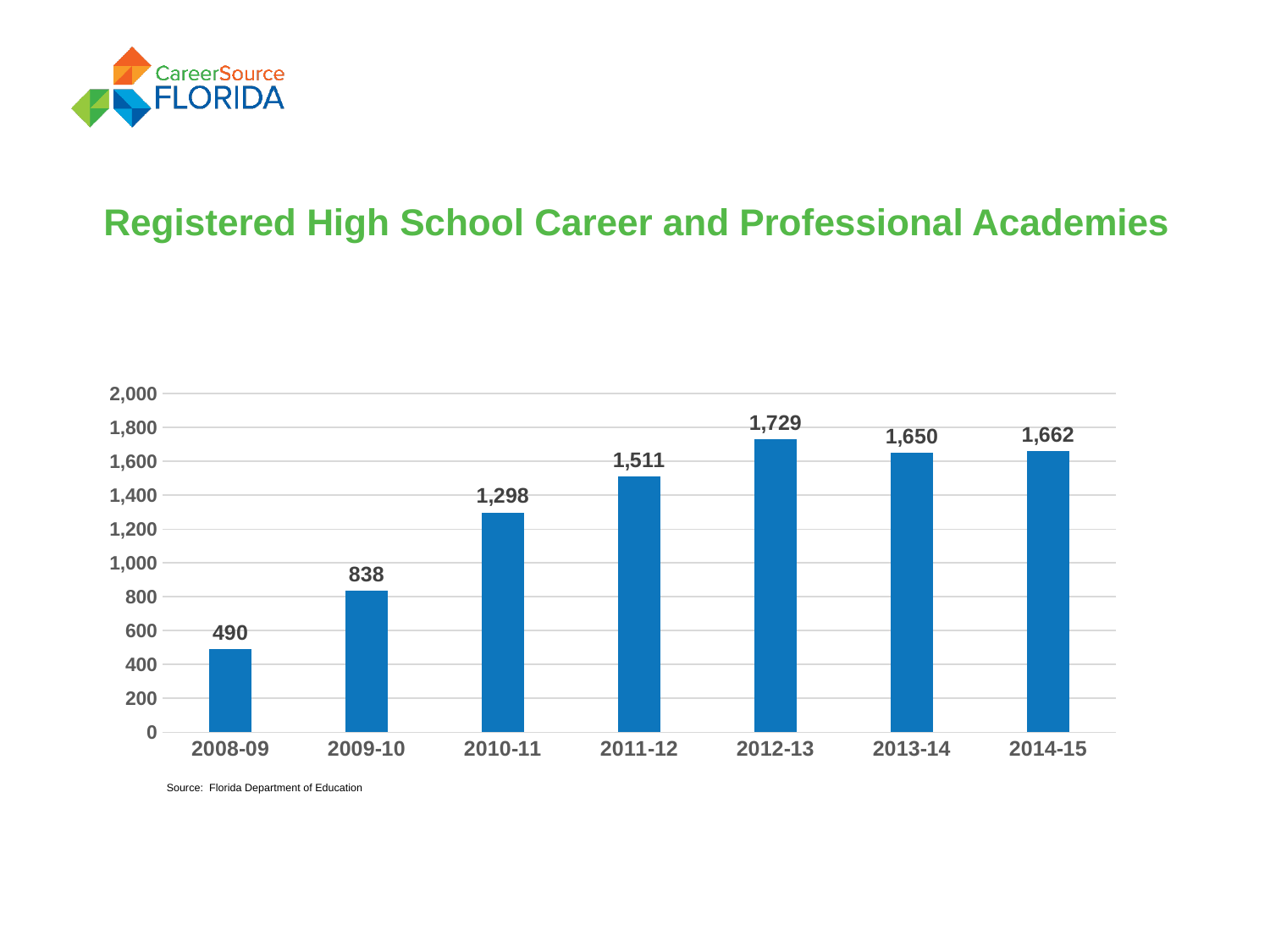
What is the difference between the values for 2012-13 and 2013-14? 79 What is the title of the chart? Registered High School Career and Professional Academies What is the value for 2011-12? 1,511 Which is larger, the value for 2010-11 or the value for 2011-12? 2011-12 Which year has the highest value? 2012-13 What is the difference between the values for 2009-10 and 2008-09? 348 What kind of chart is shown on the slide? bar chart Is the value for 2010-11 greater or less than 1,200? greater What is the value for 2014-15? 1,662 Which year has the lowest value? 2008-09 What is the value for 2008-09? 490 How many years are shown on the x axis? 7